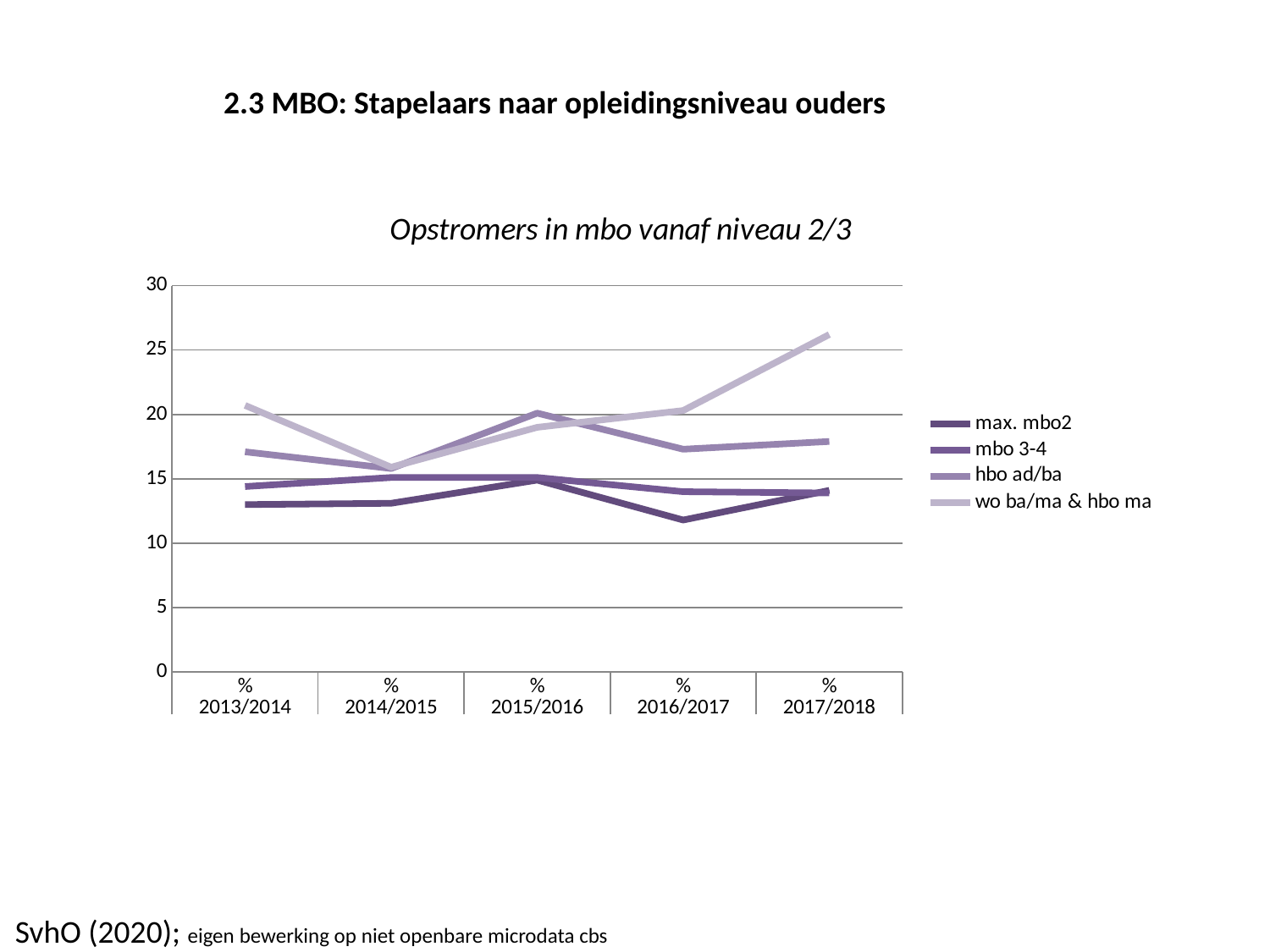
Which series has the highest value in 2017/2018? wo ba/ma & hbo ma What is the title of the chart? Opstromers in mbo vanaf niveau 2/3 How many series does the legend list? 4 Which series has the lowest value in 2016/2017? max. mbo2 Does the wo ba/ma & hbo ma line rise or fall from 2016/2017 to 2017/2018? rise Is the value for wo ba/ma & hbo ma in 2017/2018 greater or less than 25? greater How many school years are shown on the x axis? 5 Is the value for hbo ad/ba in 2015/2016 greater or less than 15? greater In 2013/2014, which is larger: wo ba/ma & hbo ma or max. mbo2? wo ba/ma & hbo ma Which series is drawn with the lightest colour in the legend? wo ba/ma & hbo ma Is the value for max. mbo2 in 2016/2017 greater or less than 15? less What kind of chart is shown on the slide? line chart